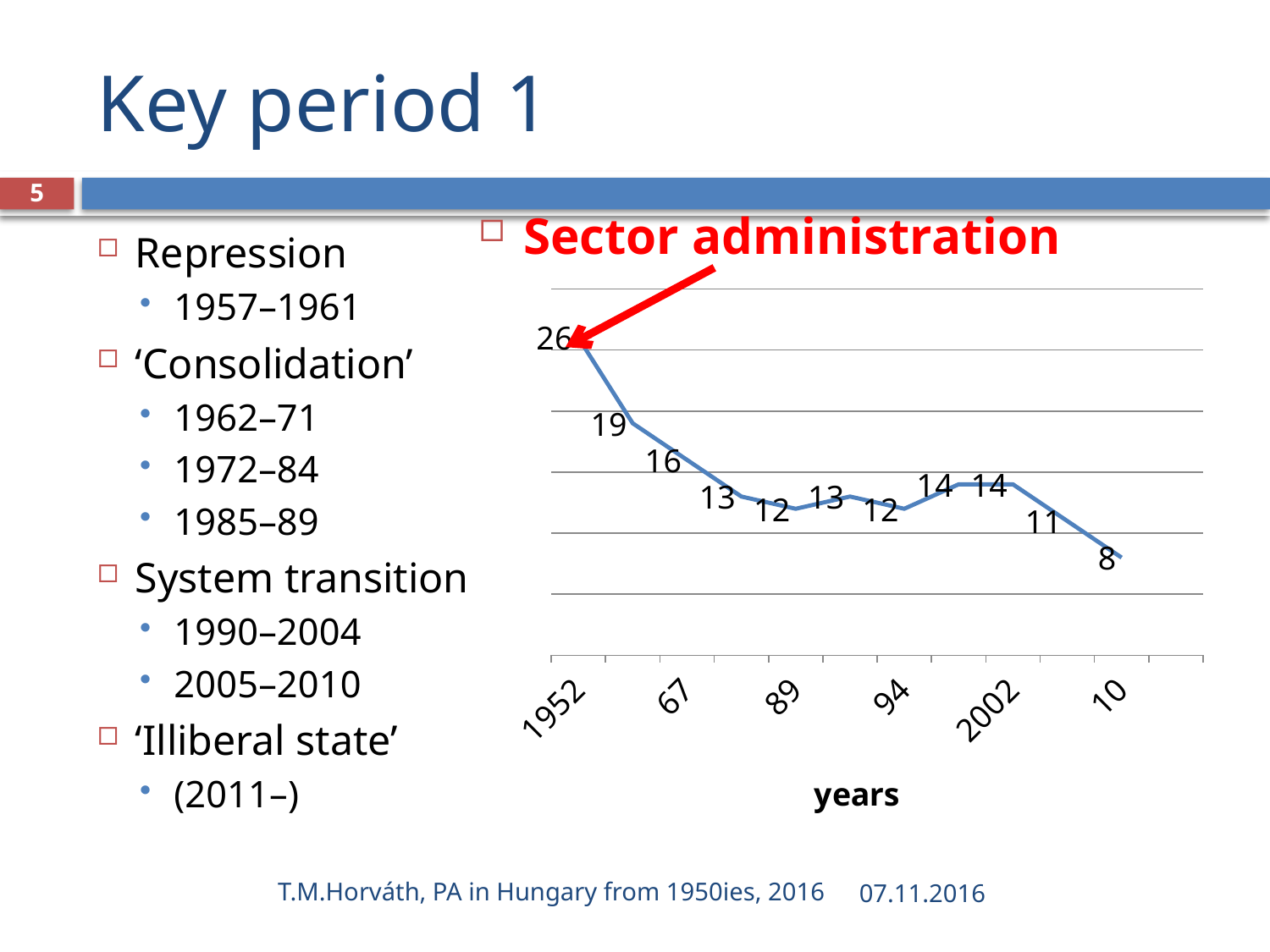
What is the value for 2002 in the Sector administration chart? 14 What is the lowest value plotted in the Sector administration chart? 8 How many data points are plotted on the line in the Sector administration chart? 11 What is the value for the last point, labelled 10, in the Sector administration chart? 8 What is the value for 67 in the Sector administration chart? 16 Do the values generally rise or fall from 1952 to 10 along the x axis? fall What is the x-axis title of the chart? years Which year has the highest value in the Sector administration chart? 1952 What kind of chart is shown on the slide? line chart What is the difference between the highest value (26) and the lowest value (8) in the chart? 18 Which is larger: the value for 1952 or the value for 2002? 1952 What is the value for 1952 in the Sector administration chart? 26